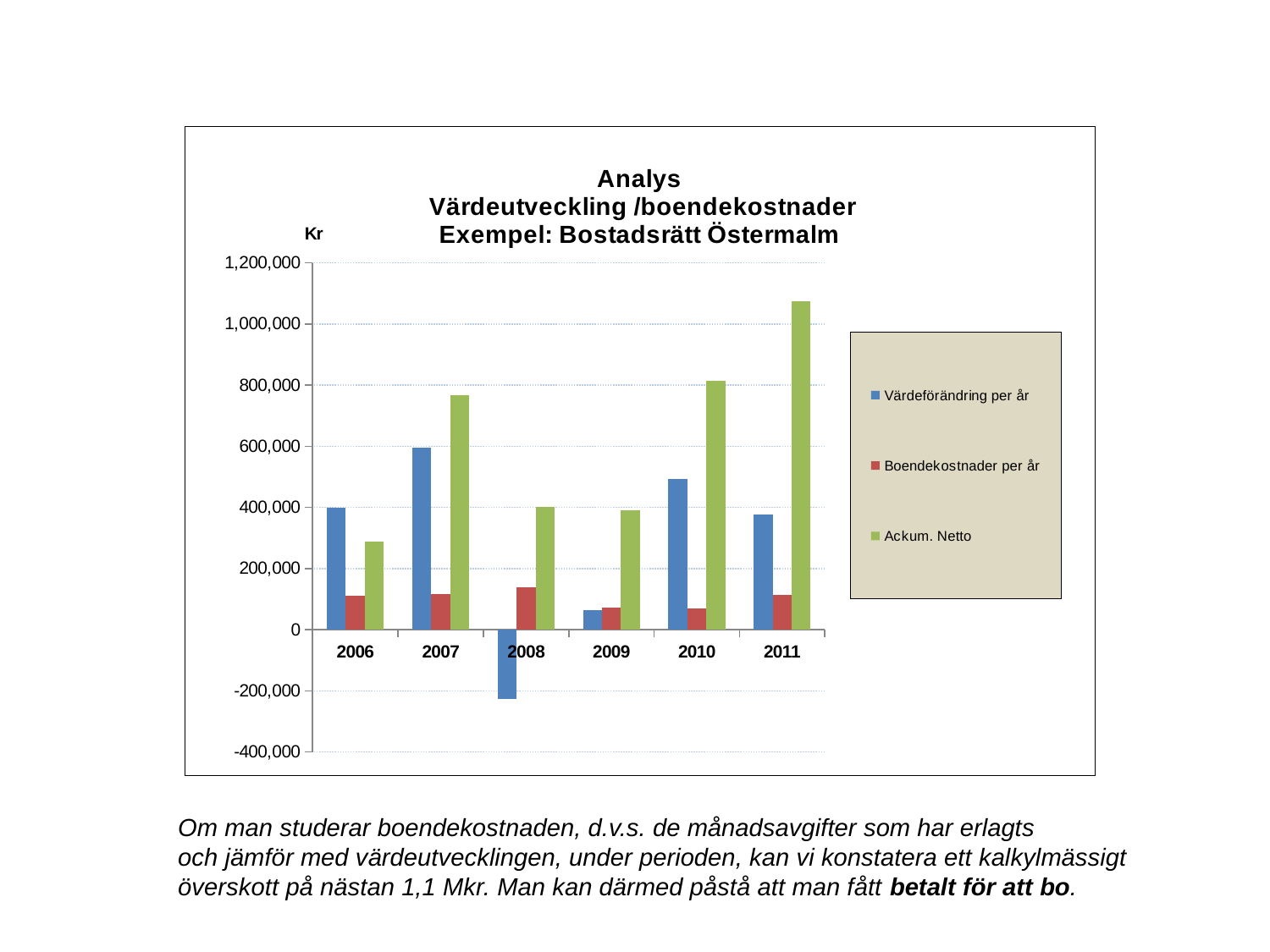
Which year has the larger Ackum. Netto, 2007 or 2010? 2010 In which year is Ackum. Netto highest? 2011 In which year is Boendekostnader per år highest? 2008 Is the value of Boendekostnader per år for 2008 greater or less than 200,000? less How many series does the legend list? 3 Is the value of Ackum. Netto for 2011 greater or less than 1,000,000? greater Is the value of Värdeförändring per år for 2008 greater or less than 0? less In which year is Värdeförändring per år highest? 2007 How many years are shown on the x axis? 6 Which year has the larger Värdeförändring per år, 2007 or 2010? 2007 What kind of chart is shown on the slide? bar chart In which year is Värdeförändring per år lowest? 2008